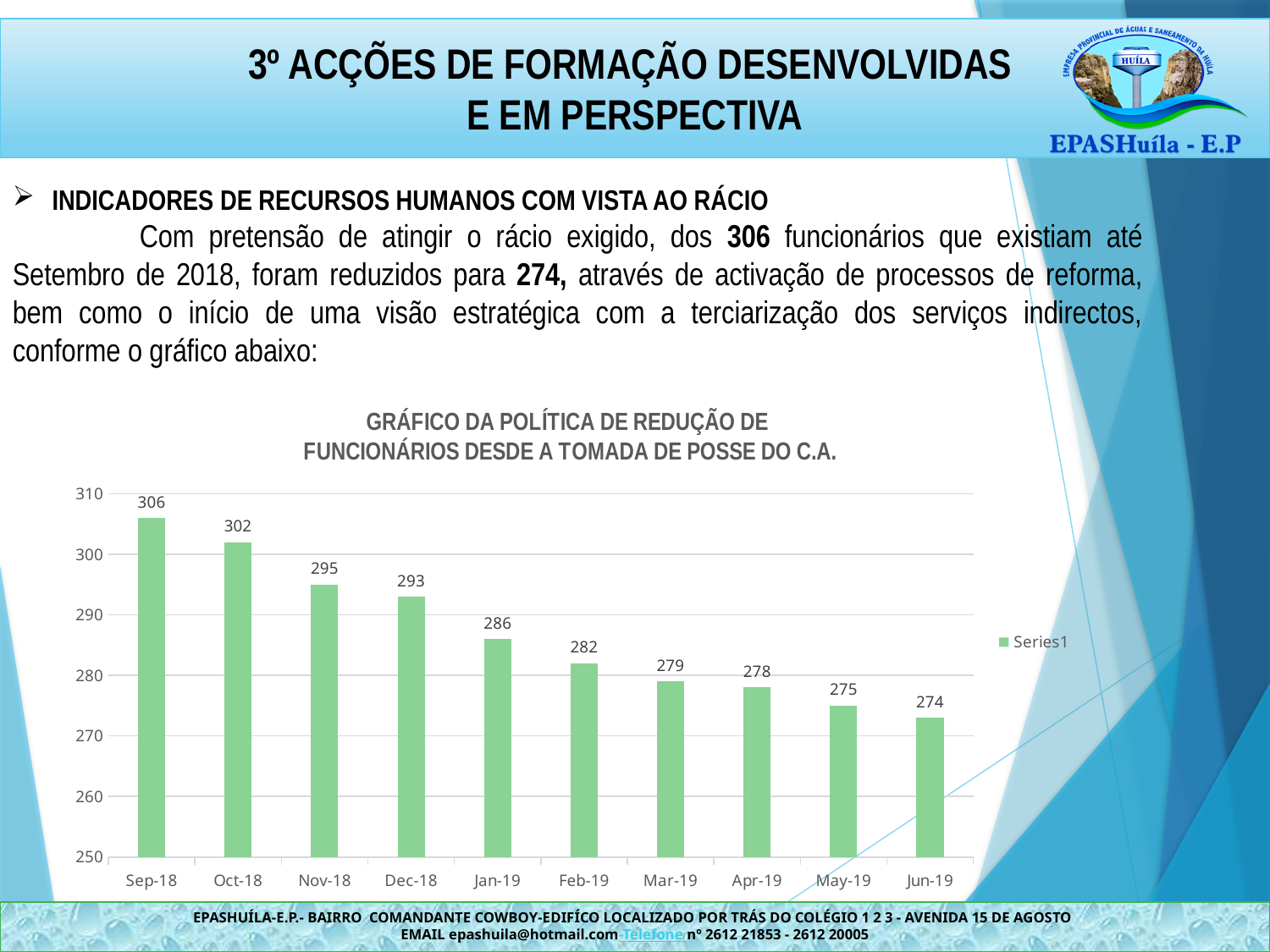
What is the value for Jun-19? 274 What is the difference between the values for Nov-18 and Dec-18? 2 What is the value for Jan-19? 286 How many months are shown on the x axis? 10 What is the value for Sep-18? 306 Which month has the highest value? Sep-18 Which month has the lowest value? Jun-19 What is the difference between the values for Sep-18 and Jun-19? 32 Is the value for Mar-19 greater or less than 280? less Which is larger, the value for Oct-18 or the value for Feb-19? Oct-18 What kind of chart is shown? bar chart Do the values rise or fall from Sep-18 to Jun-19? fall